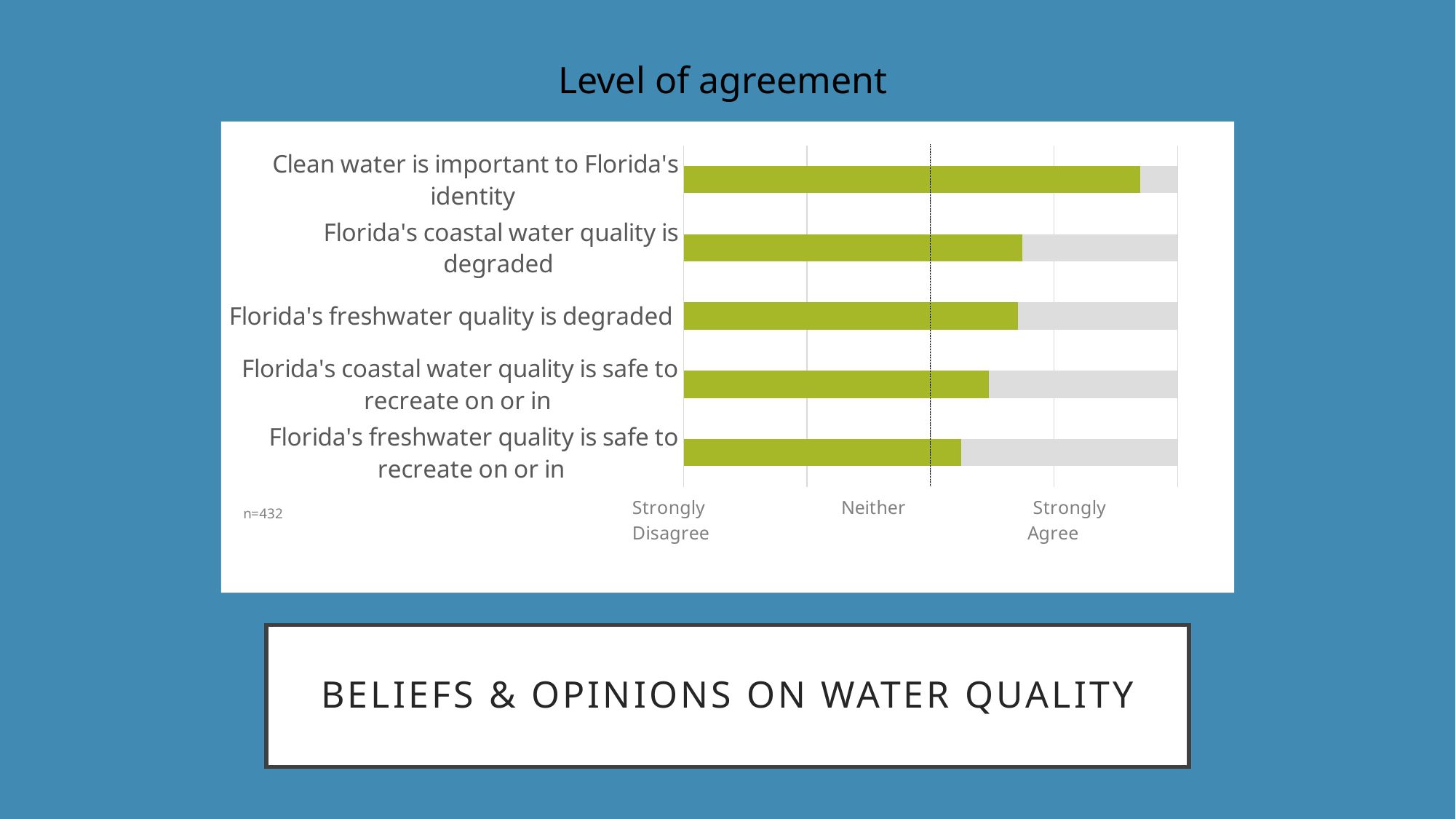
Which has a higher level of agreement: 'Florida's freshwater quality is degraded' or 'Florida's freshwater quality is safe to recreate on or in'? Florida's freshwater quality is degraded What are the three labels shown along the horizontal axis, from left to right? Strongly Disagree, Neither, Strongly Agree What kind of chart is shown on the slide? bar chart Which statement has the highest level of agreement? Clean water is important to Florida's identity What sample size (n) is noted on the chart? n=432 Which statement has the lowest level of agreement? Florida's freshwater quality is safe to recreate on or in Which has a higher level of agreement: 'Florida's coastal water quality is safe to recreate on or in' or 'Florida's freshwater quality is safe to recreate on or in'? Florida's coastal water quality is safe to recreate on or in Which has a higher level of agreement: 'Clean water is important to Florida's identity' or 'Florida's coastal water quality is degraded'? Clean water is important to Florida's identity Is the level of agreement for 'Florida's freshwater quality is safe to recreate on or in' on the agree side or the disagree side of 'Neither'? agree side What is the title of the chart? Level of agreement Is the level of agreement for 'Clean water is important to Florida's identity' on the agree side or the disagree side of 'Neither'? agree side How many statements (categories) are plotted in the chart? 5